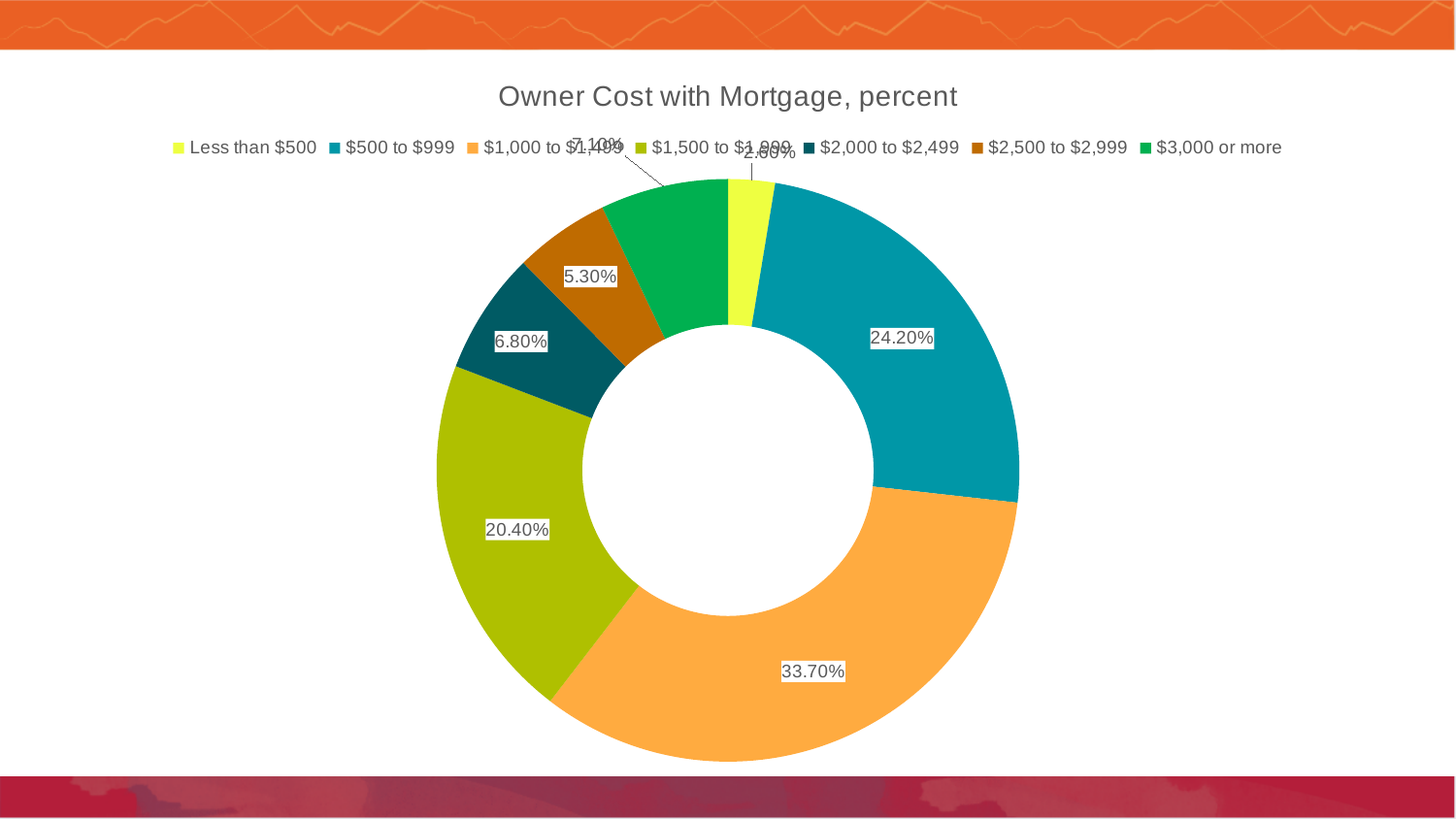
What kind of chart is shown on the slide? doughnut chart What is the value for $1,500 to $1,999? 20.40% What is the title of the chart? Owner Cost with Mortgage, percent What is the value for $1,000 to $1,499? 33.70% What is the value for $2,000 to $2,499? 6.80% How many categories does the legend list? 7 What is the value for $3,000 or more? 7.10% What is the difference between the values for $1,000 to $1,499 and $500 to $999? 9.50% What is the value for $2,500 to $2,999? 5.30% Which category has the largest share? $1,000 to $1,499 Which is larger, $2,000 to $2,499 or $2,500 to $2,999? $2,000 to $2,499 What is the value for $500 to $999? 24.20%